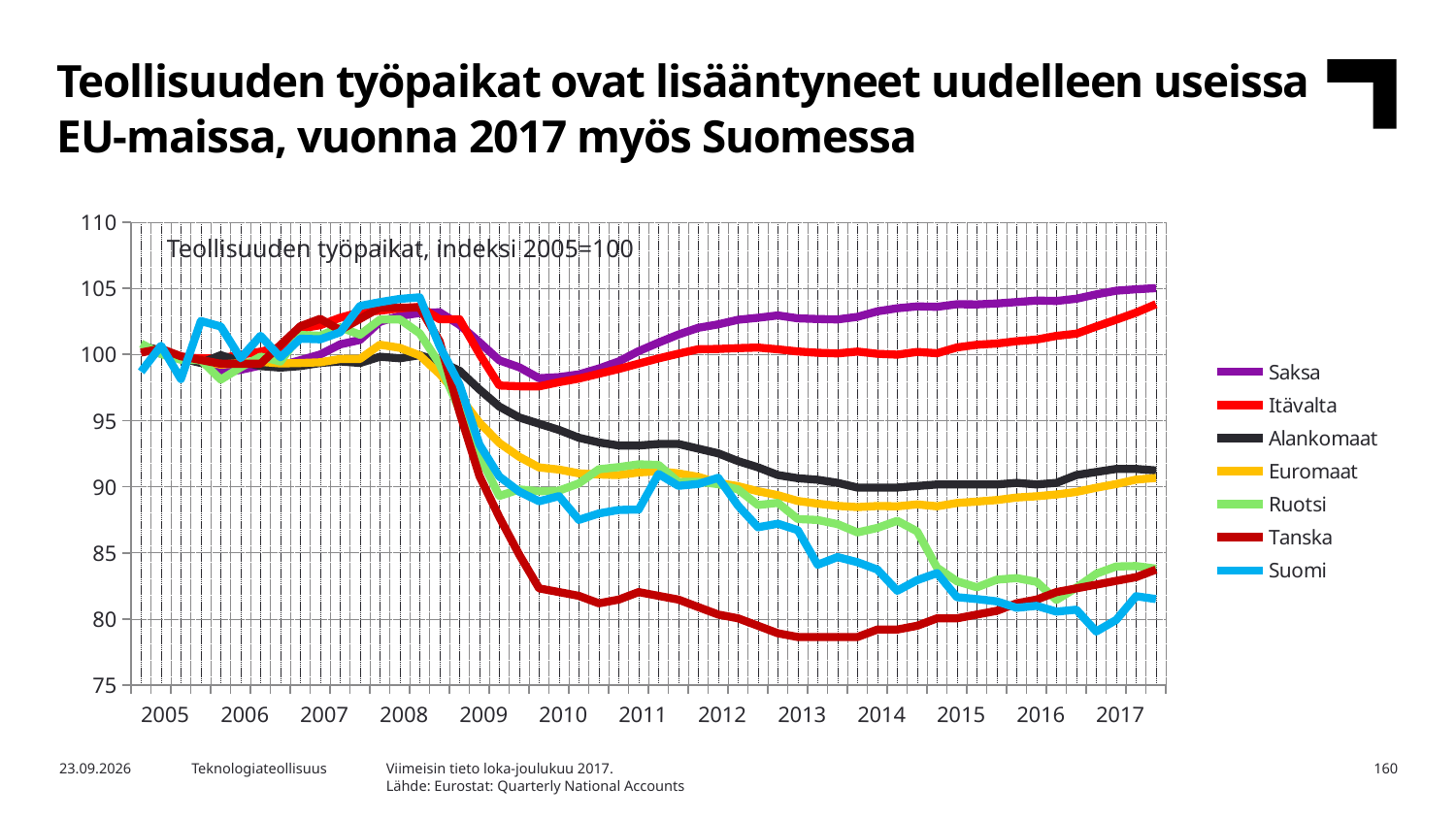
Does the Tanska line rise or fall between 2008 and 2013? fall How many series does the legend list? 7 In 2014, which is higher, Saksa or Itävalta? Saksa Does the Saksa line rise or fall between 2010 and 2017? rise Is the value for Tanska in 2013 greater or less than 80? less Is the value for Suomi in 2016 greater or less than 85? less Which series has the highest value at the end of 2017? Saksa What is the title printed inside the chart area? Teollisuuden työpaikat, indeksi 2005=100 Which series has the lowest value at the end of 2017? Suomi What type of chart is shown on the slide? line chart Which series has the lowest value in 2013? Tanska Is the value for Saksa in 2017 greater or less than 100? greater